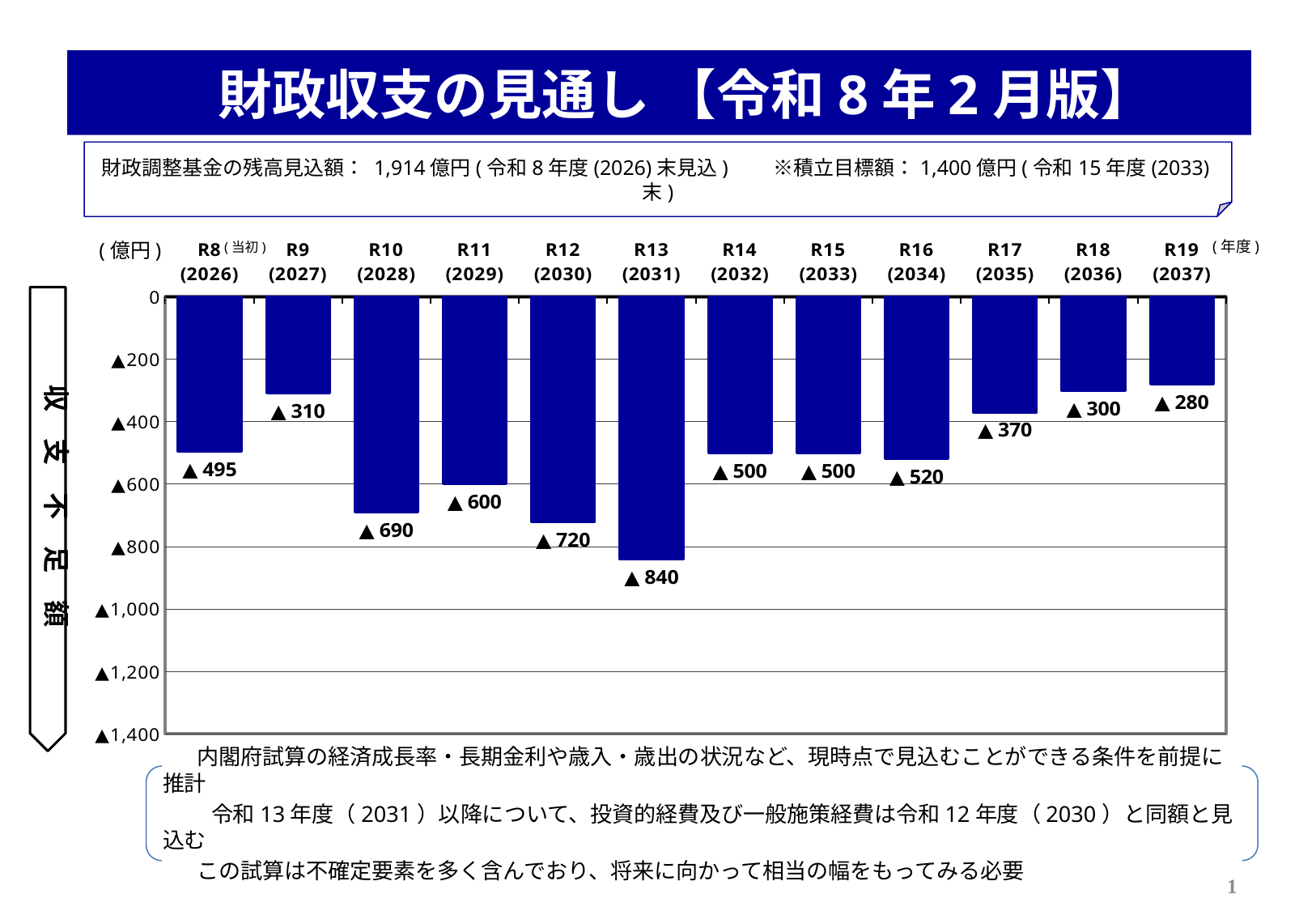
Which has the larger shortfall, R10 (2028) or R11 (2029)? R10 (2028) Which fiscal year has the smallest shortfall (shortest bar)? R19 (2037) Which fiscal year has the largest shortfall (longest bar)? R13 (2031) How many fiscal years are plotted in the chart? 12 What is the value shown for R19 (2037)? ▲280 What kind of chart is shown on the slide? Bar chart From R13 (2031) to R19 (2037), does the shortfall increase or decrease? Decrease What is the difference between the shortfall for R13 (2031) and R19 (2037)? 560 What is the value shown for R13 (2031)? ▲840 What unit is shown at the top left of the chart's vertical axis? 億円 What is the value shown for R8 (2026)? ▲495 What is the value shown for R16 (2034)? ▲520